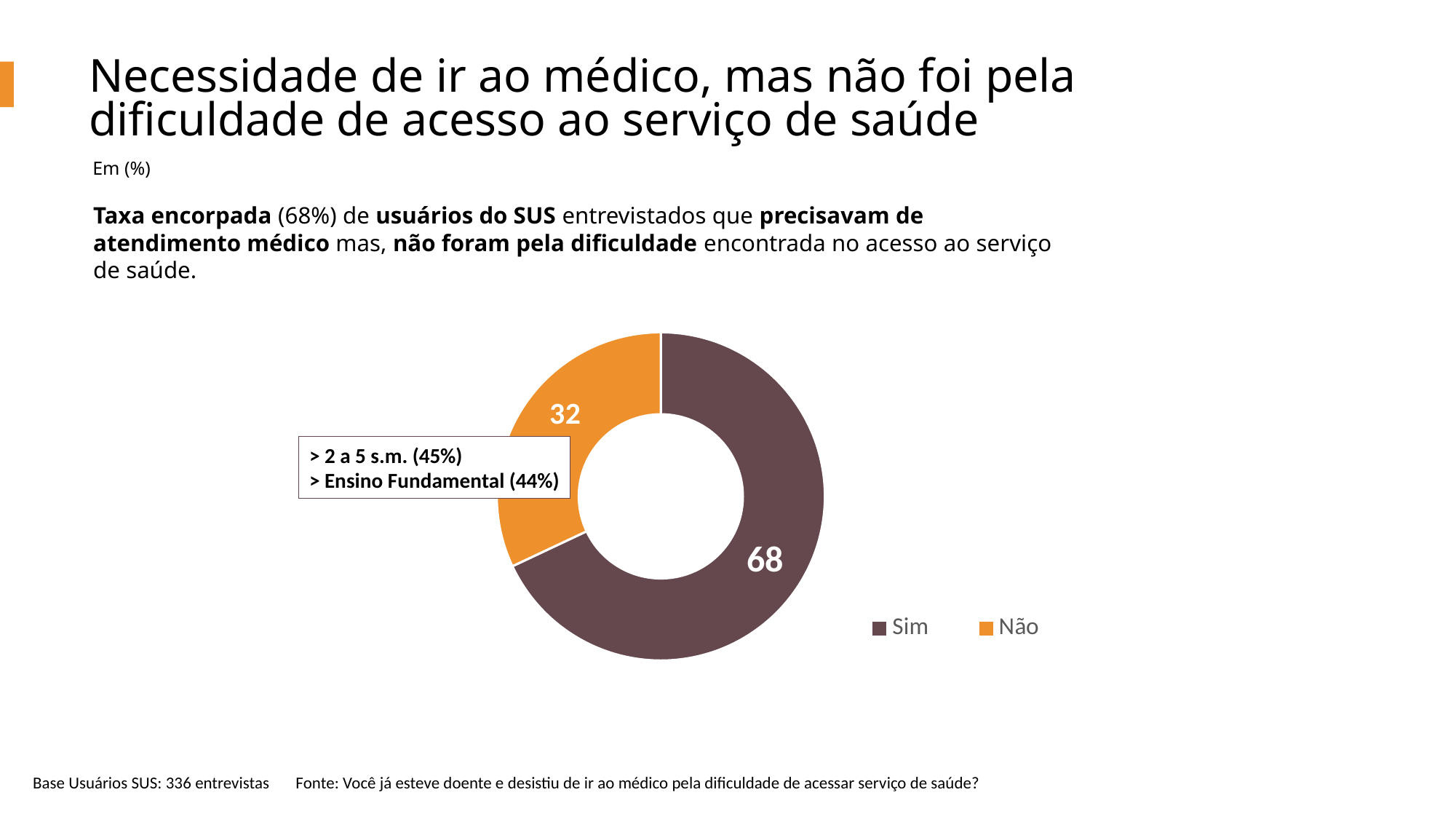
How many slices does the donut chart have? 2 Which slice of the donut chart is the smallest? Não What colour is the "Não" slice in the donut chart? Orange What is the difference between the "Sim" and "Não" values in the donut chart? 36 What kind of chart is shown on the slide? Donut (pie) chart What value is shown for the "Não" slice of the donut chart? 32 Which slice of the donut chart is the largest? Sim What is the total of the two values shown in the donut chart? 100 Which is larger in the donut chart, "Sim" or "Não"? Sim What value is shown for the "Sim" slice of the donut chart? 68 How many entries does the legend of the donut chart list? 2 What percentage is shown for "Ensino Fundamental" in the callout box next to the donut chart? 44%